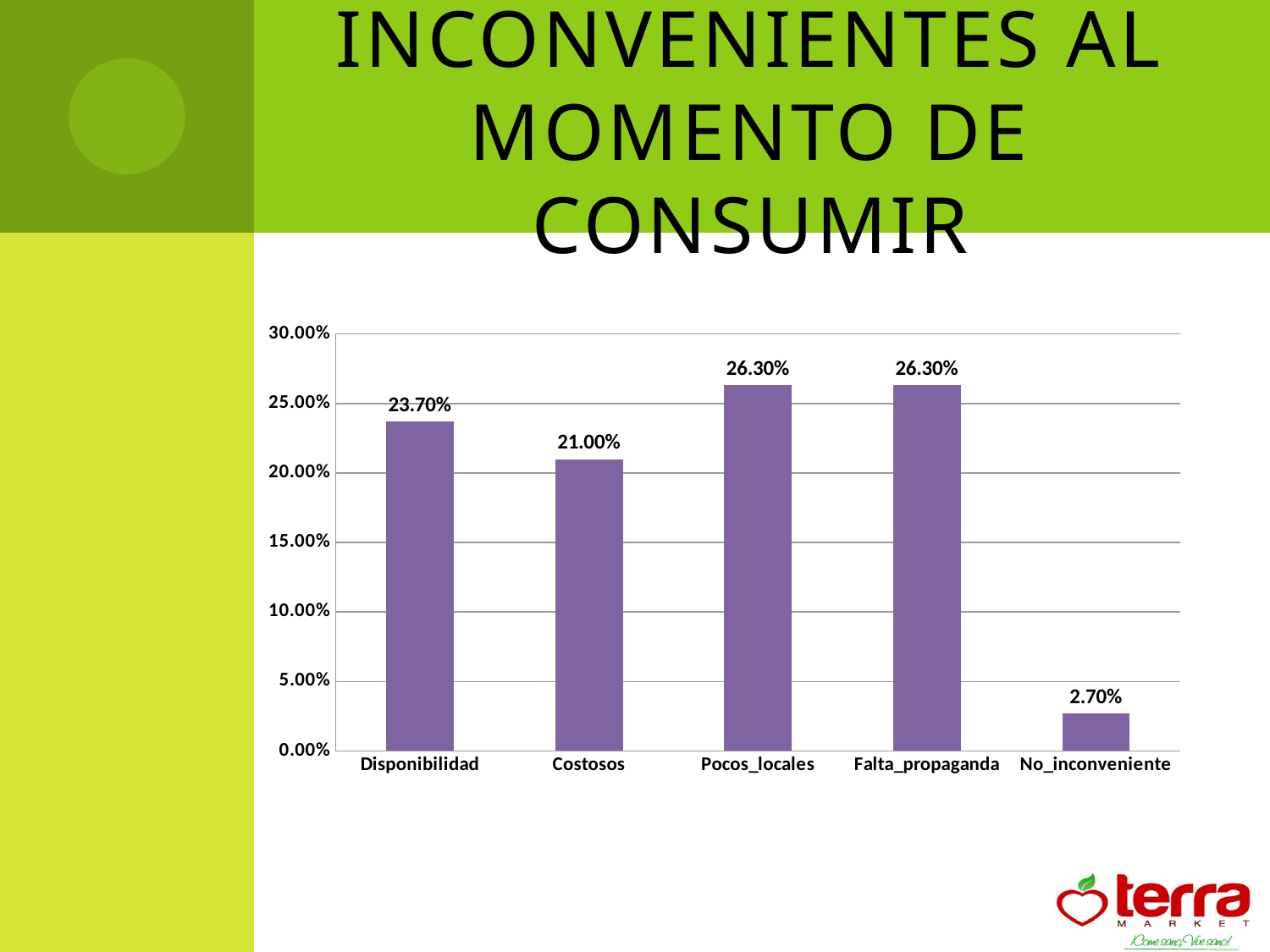
Which is larger, the value for Disponibilidad or the value for Costosos? Disponibilidad What is the title of the slide? INCONVENIENTES AL MOMENTO DE CONSUMIR What is the value for Disponibilidad? 23.70% How many categories are shown on the x axis? 5 What is the difference between the values for Disponibilidad and Costosos? 2.70% What is the difference between the values for Falta_propaganda and No_inconveniente? 23.60% What is the value for No_inconveniente? 2.70% Is the value for Costosos greater or less than 20.00%? greater What is the value for Costosos? 21.00% Which category has the lowest value? No_inconveniente What is the value for Pocos_locales? 26.30% What kind of chart is shown on the slide? bar chart